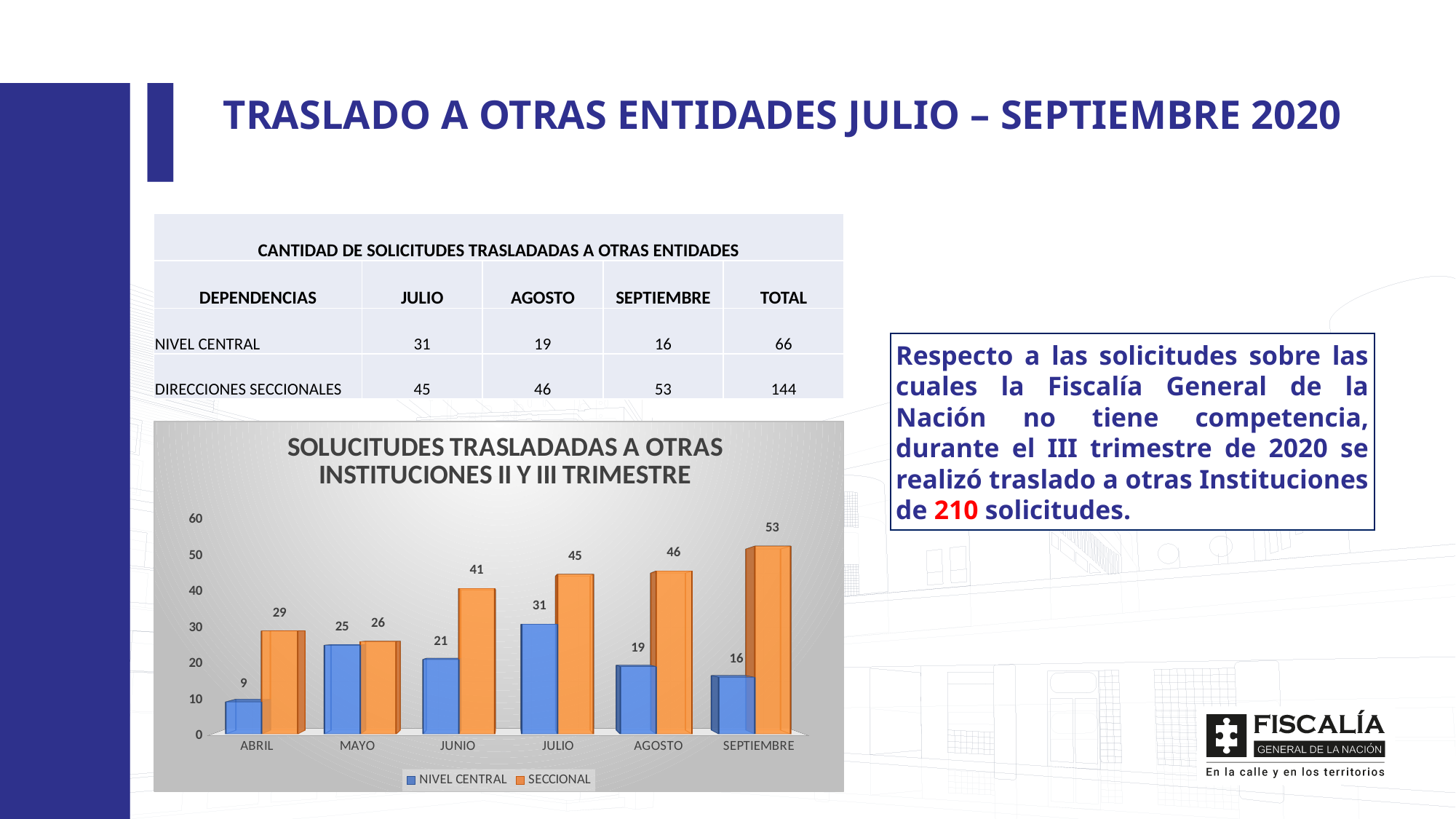
What is the value for SECCIONAL in SEPTIEMBRE? 53 What is the value for NIVEL CENTRAL in JULIO? 31 Which month has the highest SECCIONAL value? SEPTIEMBRE How many series does the chart legend list? 2 What is the title of the chart? SOLUCITUDES TRASLADADAS A OTRAS INSTITUCIONES II Y III TRIMESTRE What kind of chart is shown on the slide? Bar chart What is the difference between the SECCIONAL and NIVEL CENTRAL values in SEPTIEMBRE? 37 Which is larger in MAYO, NIVEL CENTRAL or SECCIONAL? SECCIONAL How many months are shown on the x axis of the chart? 6 Does the SECCIONAL series rise or fall from ABRIL to SEPTIEMBRE? Rise Which month has the lowest NIVEL CENTRAL value? ABRIL What is the value for NIVEL CENTRAL in ABRIL? 9